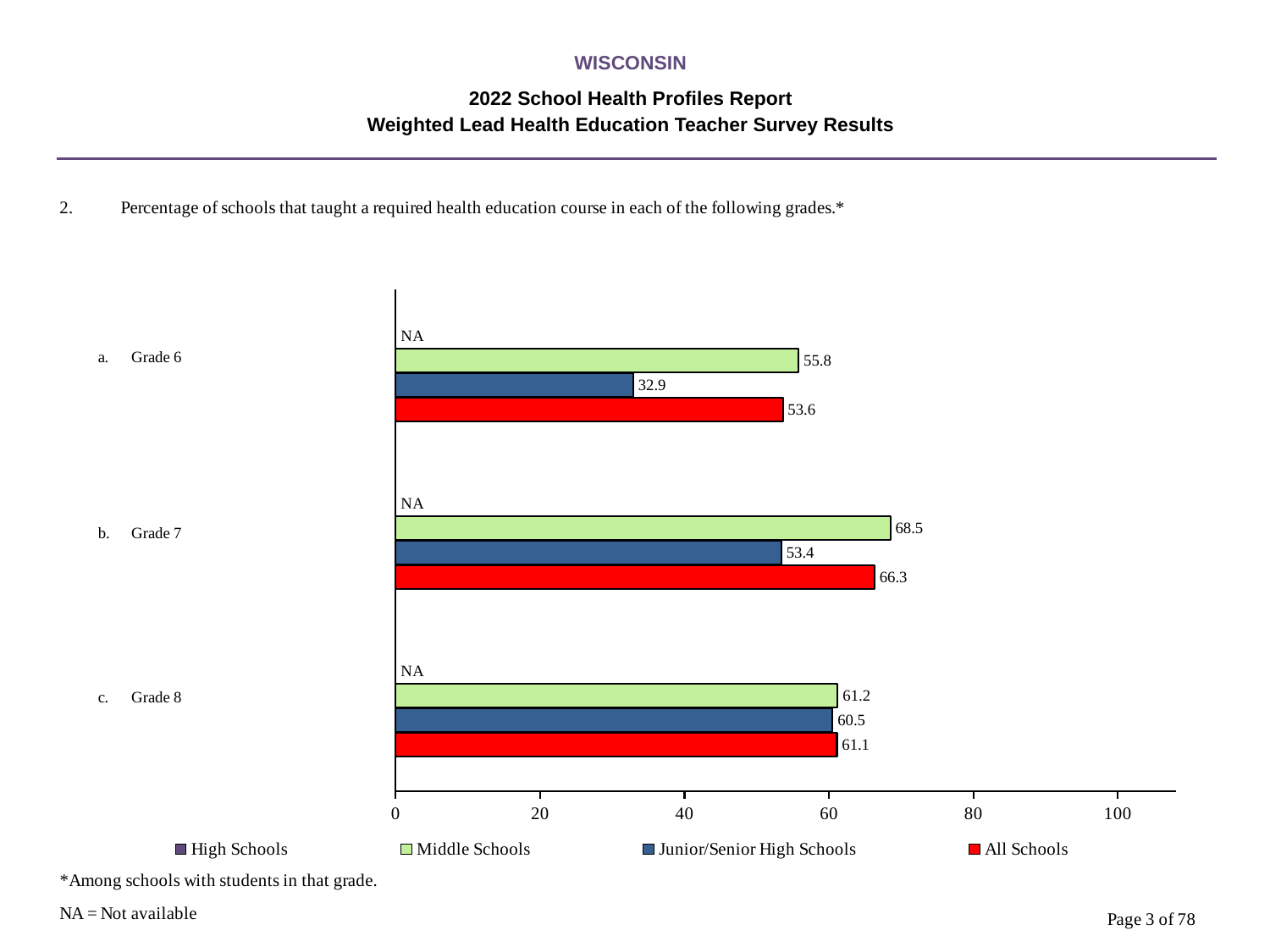
Which grade has the highest value for Middle Schools? Grade 7 Which is larger for Grade 7: the Middle Schools value or the All Schools value? Middle Schools What is the difference between the Middle Schools and Junior/Senior High Schools values for Grade 6? 22.9 What kind of chart is shown on the slide? bar chart How many series does the legend list? 4 What is the value for All Schools in Grade 8? 61.1 What is the value for Middle Schools in Grade 6? 55.8 Which grade has the lowest value for Junior/Senior High Schools? Grade 6 Is the value for Junior/Senior High Schools in Grade 6 greater or less than 40? less What is shown for High Schools in Grade 6? NA What is the value for Junior/Senior High Schools in Grade 7? 53.4 How many grade categories are shown on the chart? 3